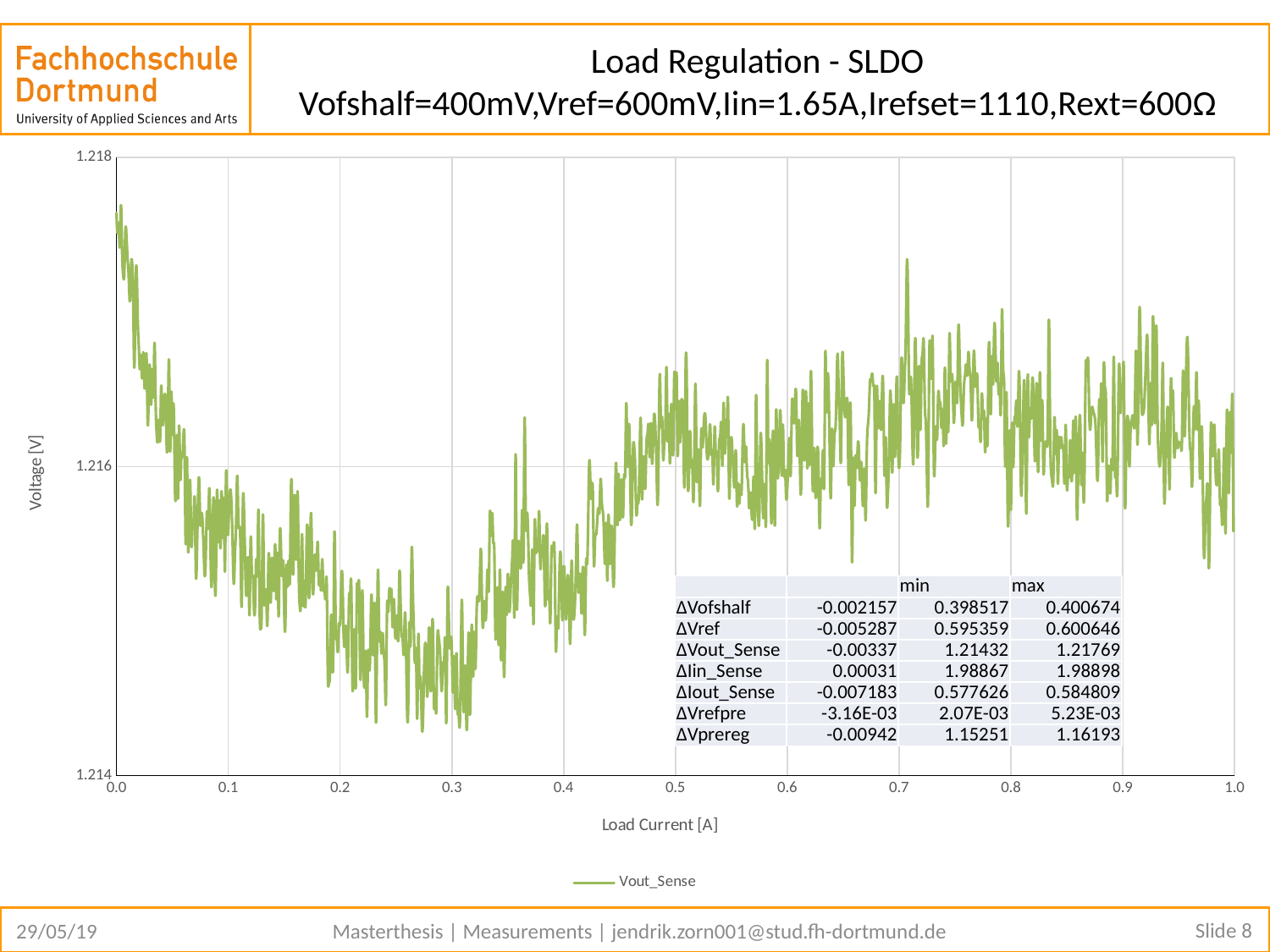
In the table on the chart, what is the max value listed for ΔVout_Sense? 1.21769 Does the Vout_Sense line rise or fall between load currents of 0.0 A and 0.3 A? fall What kind of chart is shown on the slide? line chart In the table on the chart, what is the min value listed for ΔVprereg? 1.15251 Is the value of Vout_Sense at a load current of 0.7 A greater or less than 1.216? greater What is the label of the x axis? Load Current [A] Is the value of Vout_Sense at a load current of 0.0 A greater or less than 1.216? greater What is the name of the series shown in the legend? Vout_Sense Is the Vout_Sense value at 0.3 A larger or smaller than the value at 0.7 A? smaller Does the Vout_Sense line rise or fall between load currents of 0.3 A and 0.7 A? rise How many series does the legend list? 1 Is the value of Vout_Sense at a load current of 0.3 A greater or less than 1.216? less